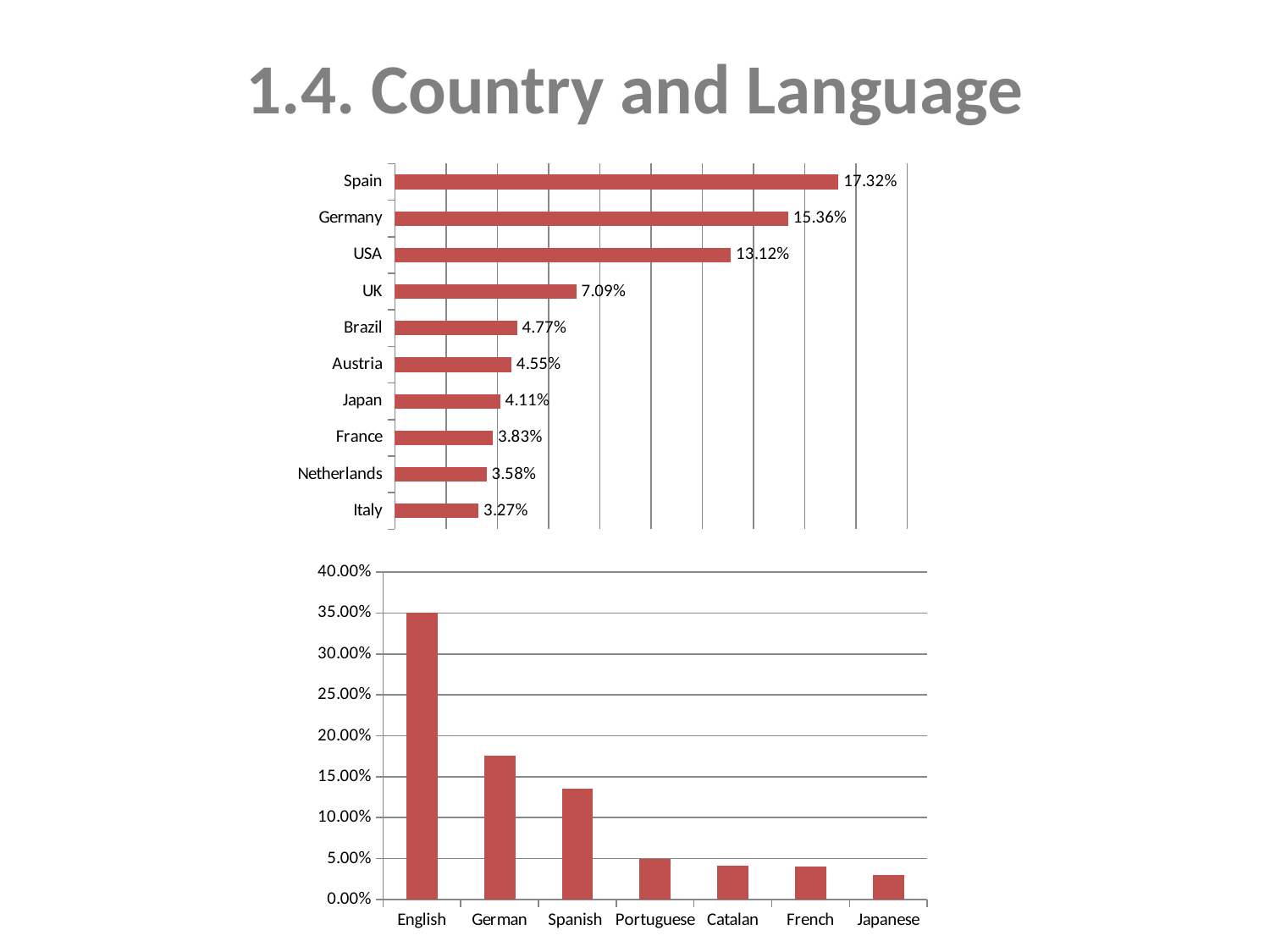
In the bottom chart, is the value for English greater or less than 30.00%? greater In the top chart, what is the difference between the values for Spain and Germany? 1.96% In the bottom chart, is the value for Japanese greater or less than 5.00%? less In the top chart, which is larger, the value for UK or the value for Brazil? UK In the top chart, what is the value for Germany? 15.36% In the bottom chart, which language has the highest value? English In the top chart, which country has the lowest value? Italy In the top chart, what is the value for Netherlands? 3.58% How many languages are shown in the bottom chart? 7 In the top chart, which country has the highest value? Spain How many countries are shown in the top chart? 10 What kind of chart is the top chart? Bar chart